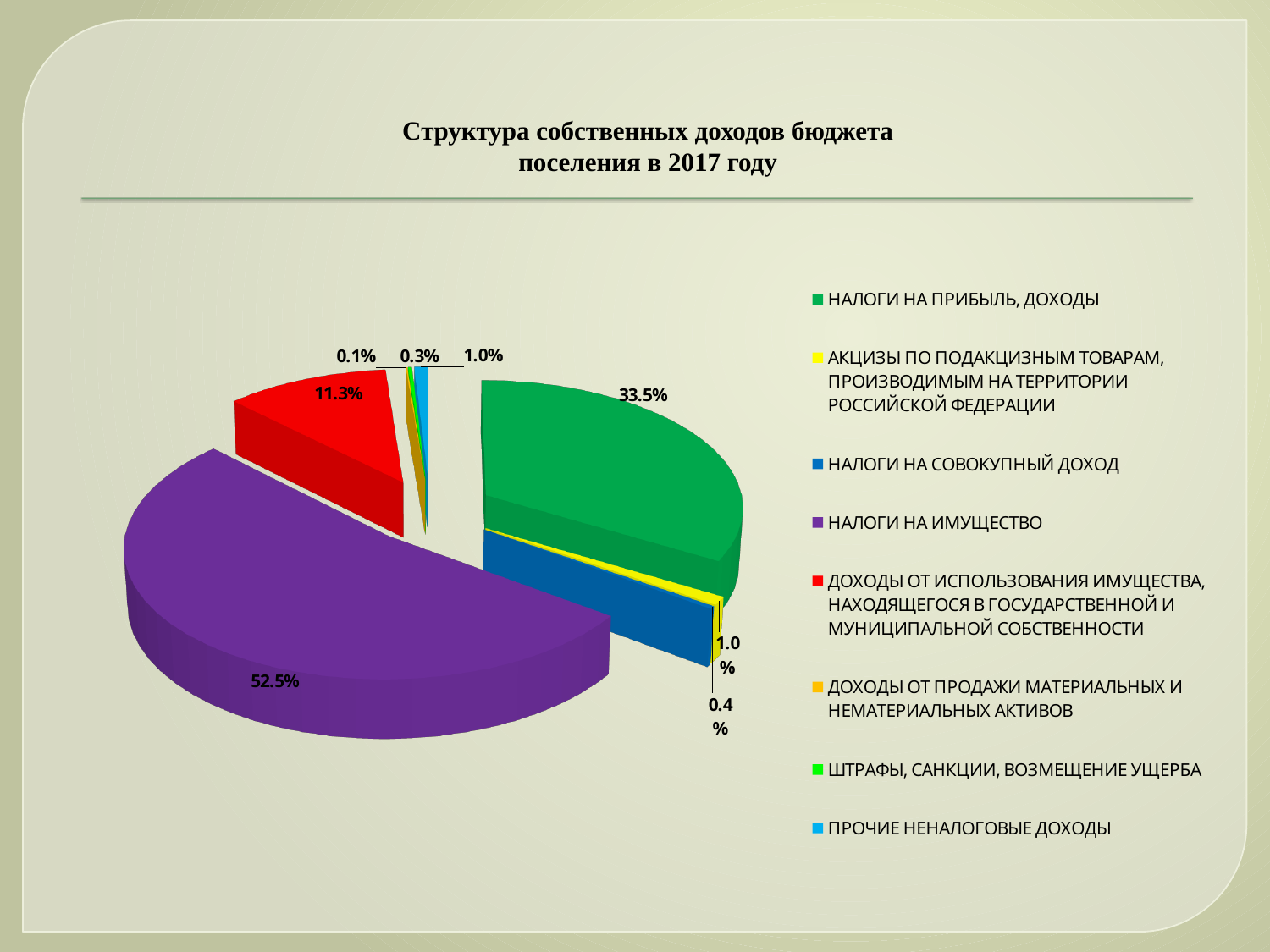
What share of the pie does «НАЛОГИ НА ПРИБЫЛЬ, ДОХОДЫ» have? 33.5% Which is larger: the share of «НАЛОГИ НА ПРИБЫЛЬ, ДОХОДЫ» or the share of «ДОХОДЫ ОТ ИСПОЛЬЗОВАНИЯ ИМУЩЕСТВА, НАХОДЯЩЕГОСЯ В ГОСУДАРСТВЕННОЙ И МУНИЦИПАЛЬНОЙ СОБСТВЕННОСТИ»? НАЛОГИ НА ПРИБЫЛЬ, ДОХОДЫ Which category has the largest slice of the pie? НАЛОГИ НА ИМУЩЕСТВО What kind of chart is shown on the slide? Pie chart Which category has the smallest slice of the pie? ДОХОДЫ ОТ ПРОДАЖИ МАТЕРИАЛЬНЫХ И НЕМАТЕРИАЛЬНЫХ АКТИВОВ How many categories does the legend list? 8 Is the share of «НАЛОГИ НА ИМУЩЕСТВО» greater or less than 50%? greater What is the title of the chart? Структура собственных доходов бюджета поселения в 2017 году What share of the pie does «ДОХОДЫ ОТ ИСПОЛЬЗОВАНИЯ ИМУЩЕСТВА, НАХОДЯЩЕГОСЯ В ГОСУДАРСТВЕННОЙ И МУНИЦИПАЛЬНОЙ СОБСТВЕННОСТИ» have? 11.3% What share of the pie does «НАЛОГИ НА ИМУЩЕСТВО» have? 52.5% What is the difference in percentage points between «НАЛОГИ НА ИМУЩЕСТВО» and «НАЛОГИ НА ПРИБЫЛЬ, ДОХОДЫ»? 19.0 What colour is the slice for «НАЛОГИ НА ИМУЩЕСТВО»? Purple